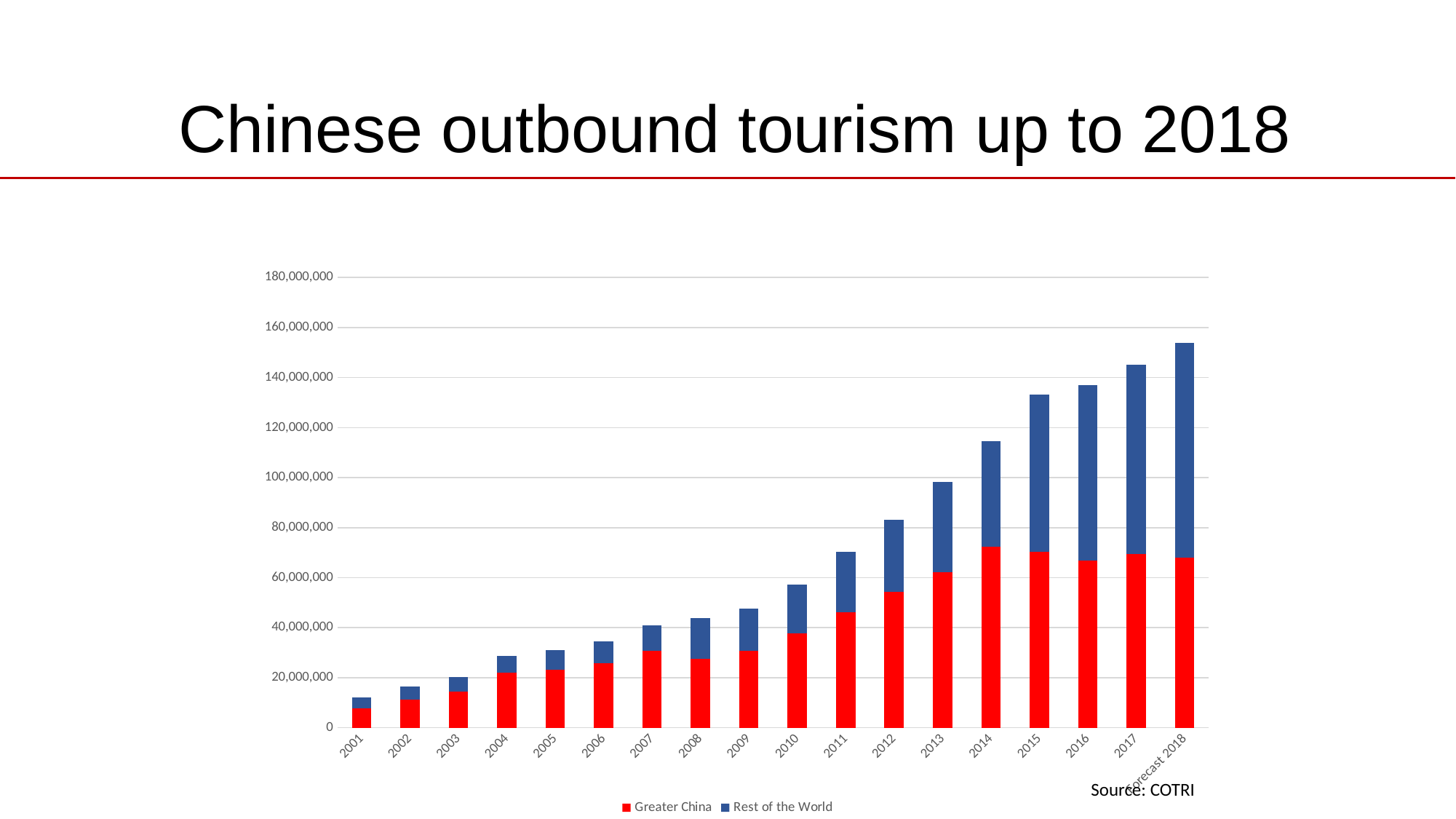
Which year has the highest total bar? Forecast 2018 What kind of chart is shown on the slide? Stacked bar chart How many series does the legend list? 2 How many categories (years) are shown on the x axis? 18 Do the total bar heights generally rise or fall from 2001 to Forecast 2018? Rise Which year has the lowest total bar? 2001 Is the total value for Forecast 2018 greater or less than 140,000,000? greater Is the total value for 2014 greater or less than 100,000,000? greater In Forecast 2018, which series has the larger value, Greater China or Rest of the World? Rest of the World Which colour represents the Greater China series? Red Is the total value for 2009 greater or less than 60,000,000? less